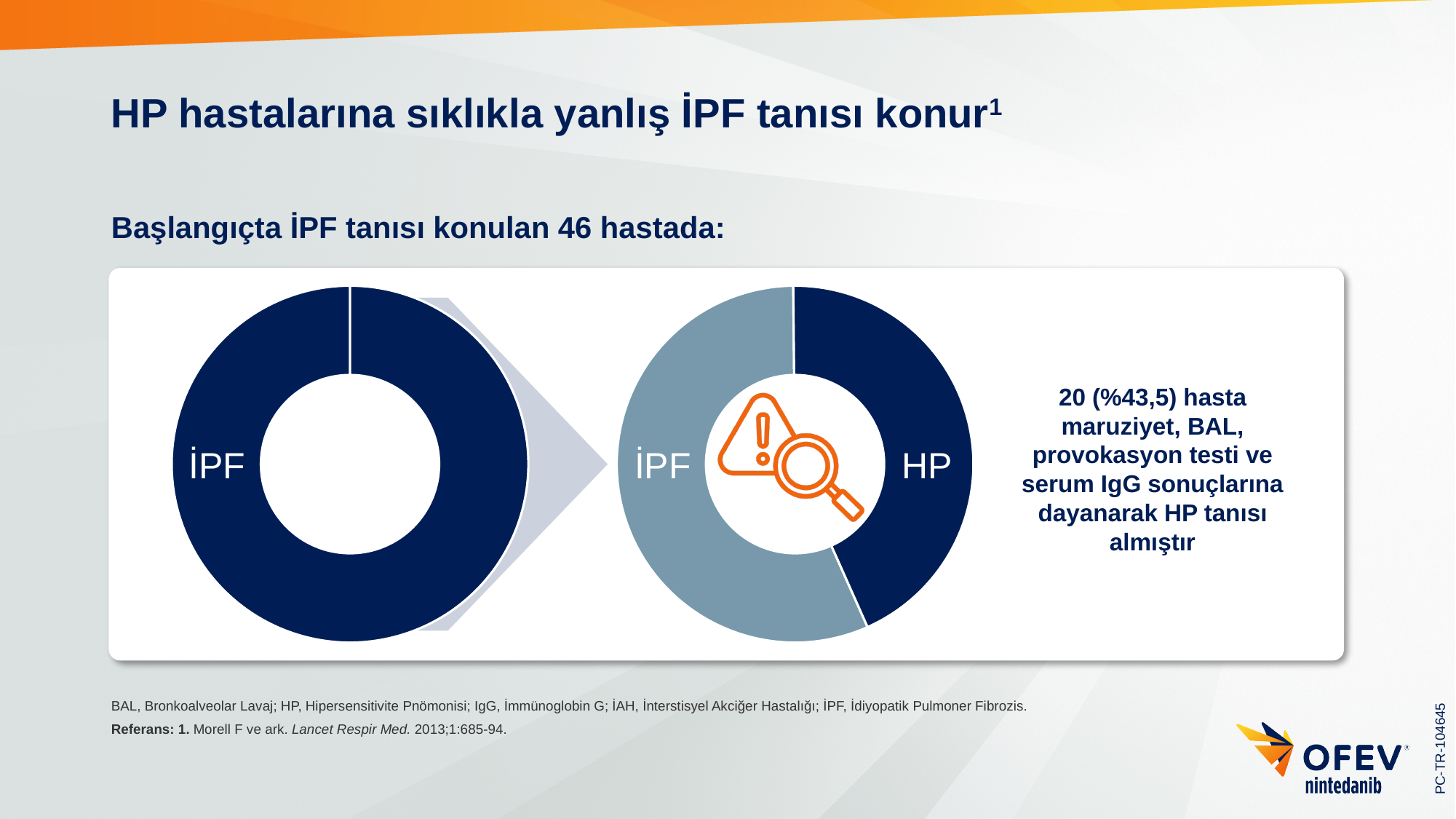
In the right-hand chart, is the HP share greater or less than 50%? less Of the 46 patients, how many did not receive the HP diagnosis (46 minus 20)? 26 What label appears on the left-hand chart? İPF In the right-hand chart, how many patients received an HP diagnosis? 20 In the right-hand chart, what share of patients received an HP diagnosis? %43,5 How many charts are shown on the slide? 2 In the right-hand chart, how many categories are shown? 2 What kind of chart is used on the slide? Pie chart (donut) In the right-hand chart, which slice is larger, İPF or HP? İPF How many patients were initially diagnosed with İPF according to the slide? 46 In the left-hand chart, how many categories are shown? 1 In the right-hand chart, what colour is the HP slice? Dark navy blue